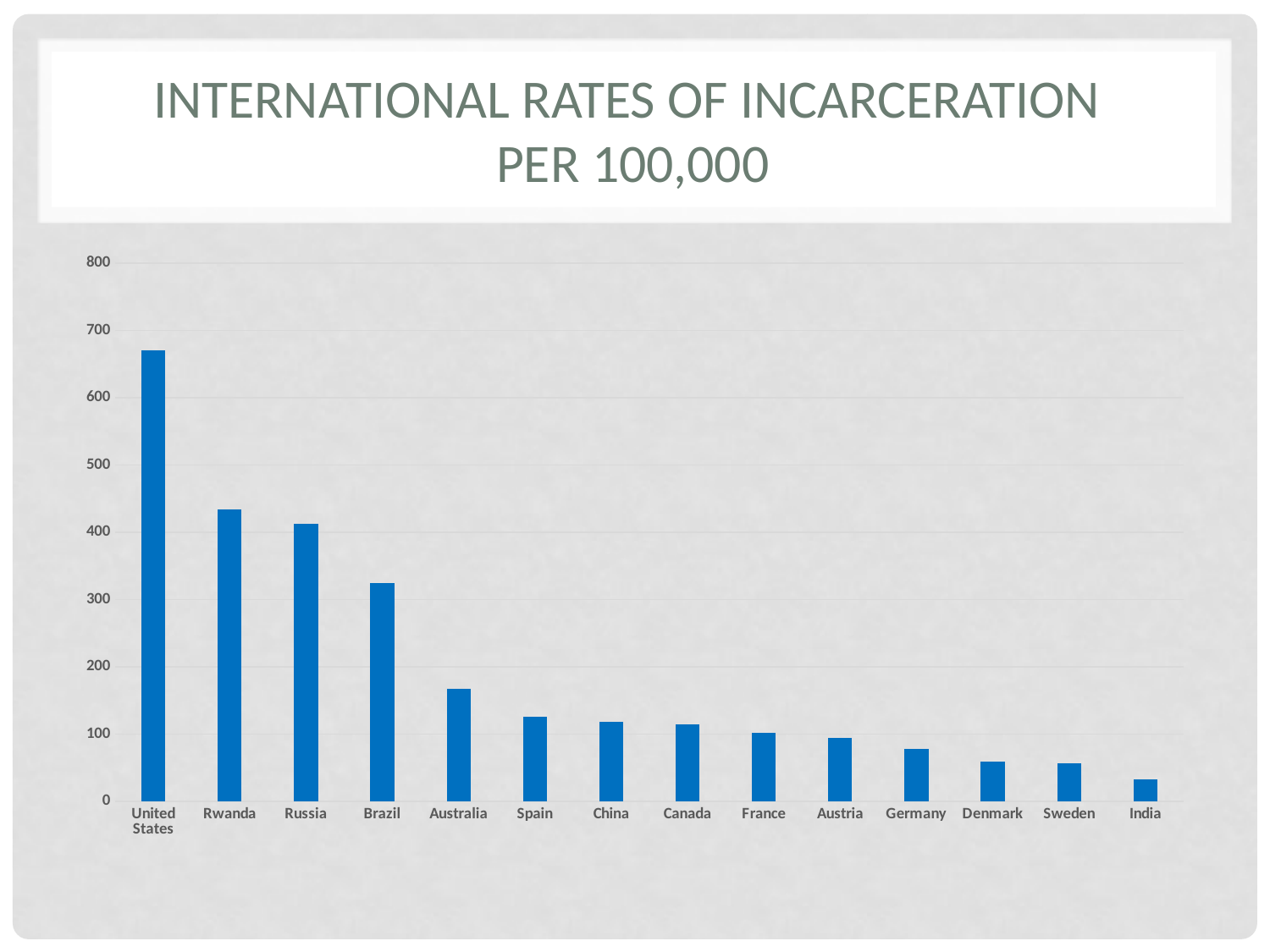
Which has a higher incarceration rate, Brazil or Australia? Brazil Which country has the lowest incarceration rate on the chart? India Is the value for Germany greater or less than 100? less Is the value for Rwanda greater or less than 400? greater Do the values rise or fall moving from left to right across the chart? fall Is the value for Brazil greater or less than 300? greater What kind of chart is shown on the slide? bar chart Which country has the highest incarceration rate on the chart? United States What is the title of the slide? International Rates of Incarceration per 100,000 How many countries are shown on the chart? 14